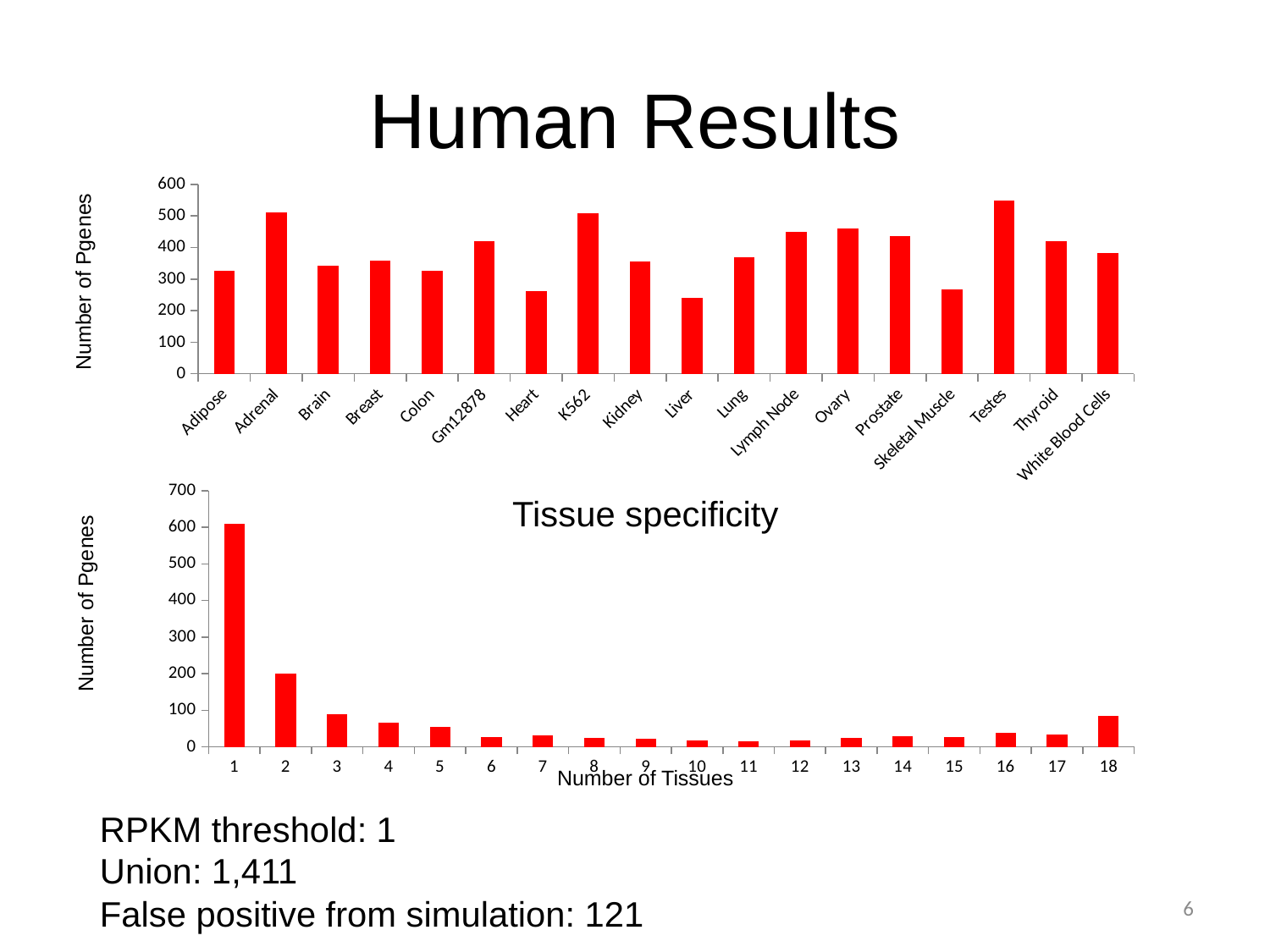
In the top chart, is the value for Heart greater or less than 300? less What is the x-axis label of the Tissue specificity chart? Number of Tissues In the Tissue specificity chart, which has more Pgenes, 17 tissues or 18 tissues? 18 In the top chart, is the value for Testes greater or less than 500? greater In the Tissue specificity chart, is the value for 1 tissue greater or less than 500? greater In the top chart, which tissue has the highest number of Pgenes? Testes In the Tissue specificity chart, which number of tissues has the highest number of Pgenes? 1 In the top chart, which has more Pgenes, Lymph Node or Heart? Lymph Node What kind of chart is the Tissue specificity chart? bar chart In the top chart, which tissue has the lowest number of Pgenes? Liver How many tissues are shown on the x axis of the top chart? 18